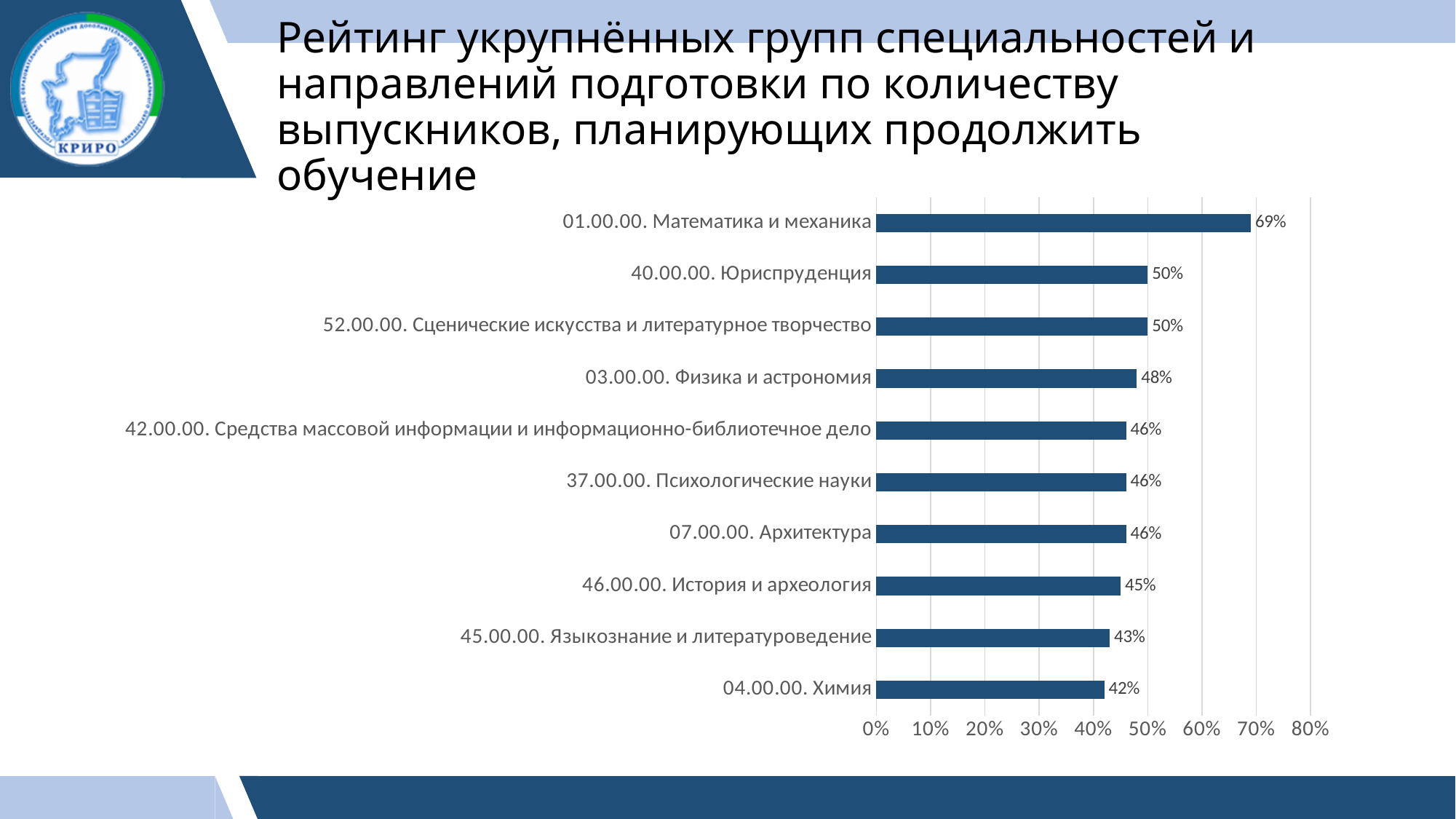
What is the value for 04.00.00. Химия? 42% What is the value for 01.00.00. Математика и механика? 69% Which category has the lowest value? 04.00.00. Химия Which category has the highest value? 01.00.00. Математика и механика Is the value for 01.00.00. Математика и механика greater or less than 60%? greater What is the difference between the values for 01.00.00. Математика и механика and 04.00.00. Химия? 27% What is the difference between the values for 40.00.00. Юриспруденция and 46.00.00. История и археология? 5% What kind of chart is shown on the slide? bar chart What is the value for 45.00.00. Языкознание и литературоведение? 43% How many categories are shown in the chart? 10 Which is larger, the value for 03.00.00. Физика и астрономия or the value for 45.00.00. Языкознание и литературоведение? 03.00.00. Физика и астрономия What is the value for 03.00.00. Физика и астрономия? 48%